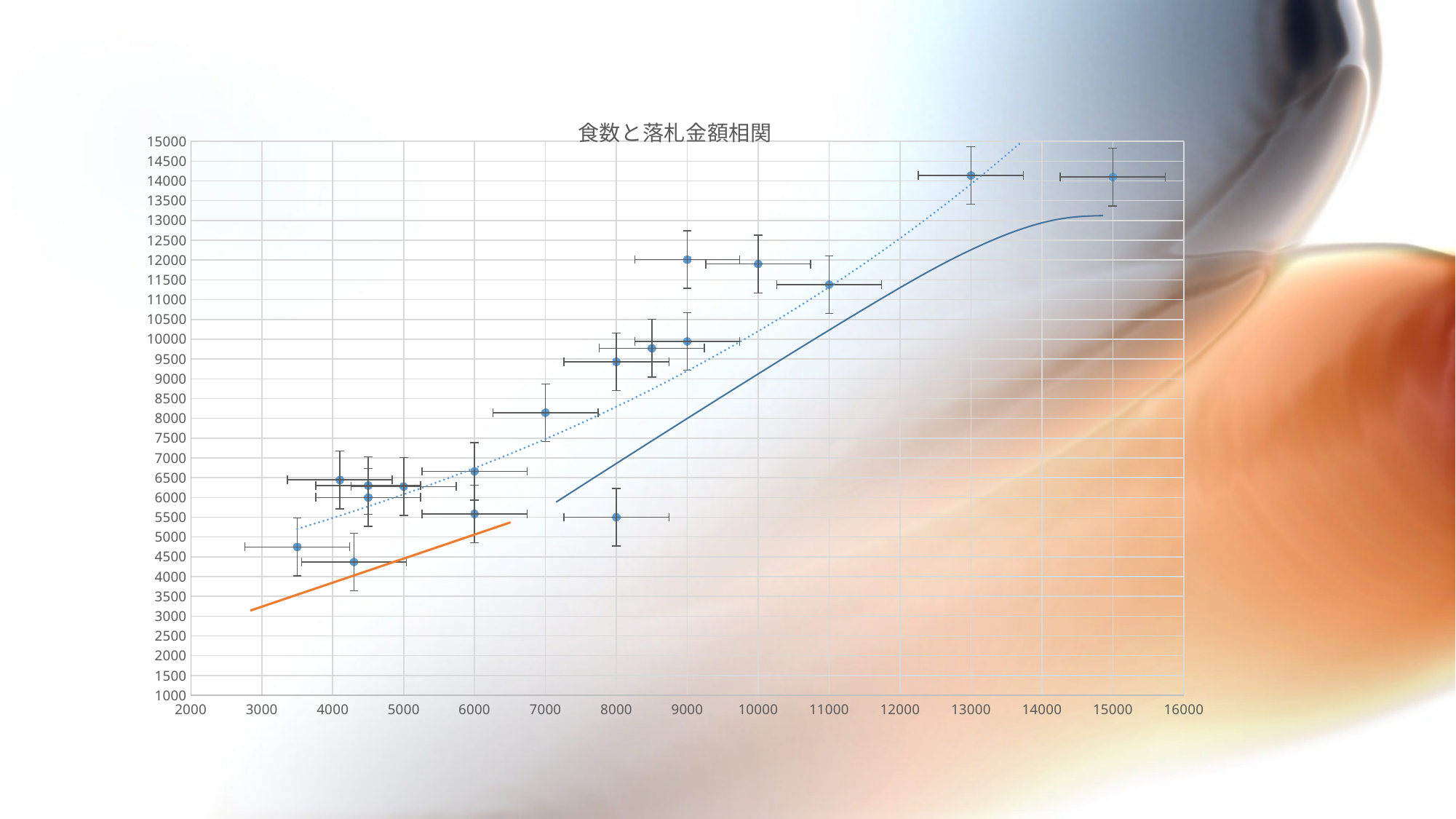
Is the y value of the point at x = 11000 greater or less than 10000? greater Is the y value of the lower point at x = 8000 greater or less than 6000? less Is the y value of the point at x = 15000 greater or less than 13000? greater What kind of chart is shown on the slide? scatter chart What is the title of the chart? 食数と落札金額相関 Which has the higher y value: the point at x = 9000 near 12000 or the point at x = 7000? the point at x = 9000 What is the maximum value shown on the y axis? 15000 Do the plotted values generally rise or fall as the x-axis value increases? rise What is the largest x-axis value at which a data point is plotted? 15000